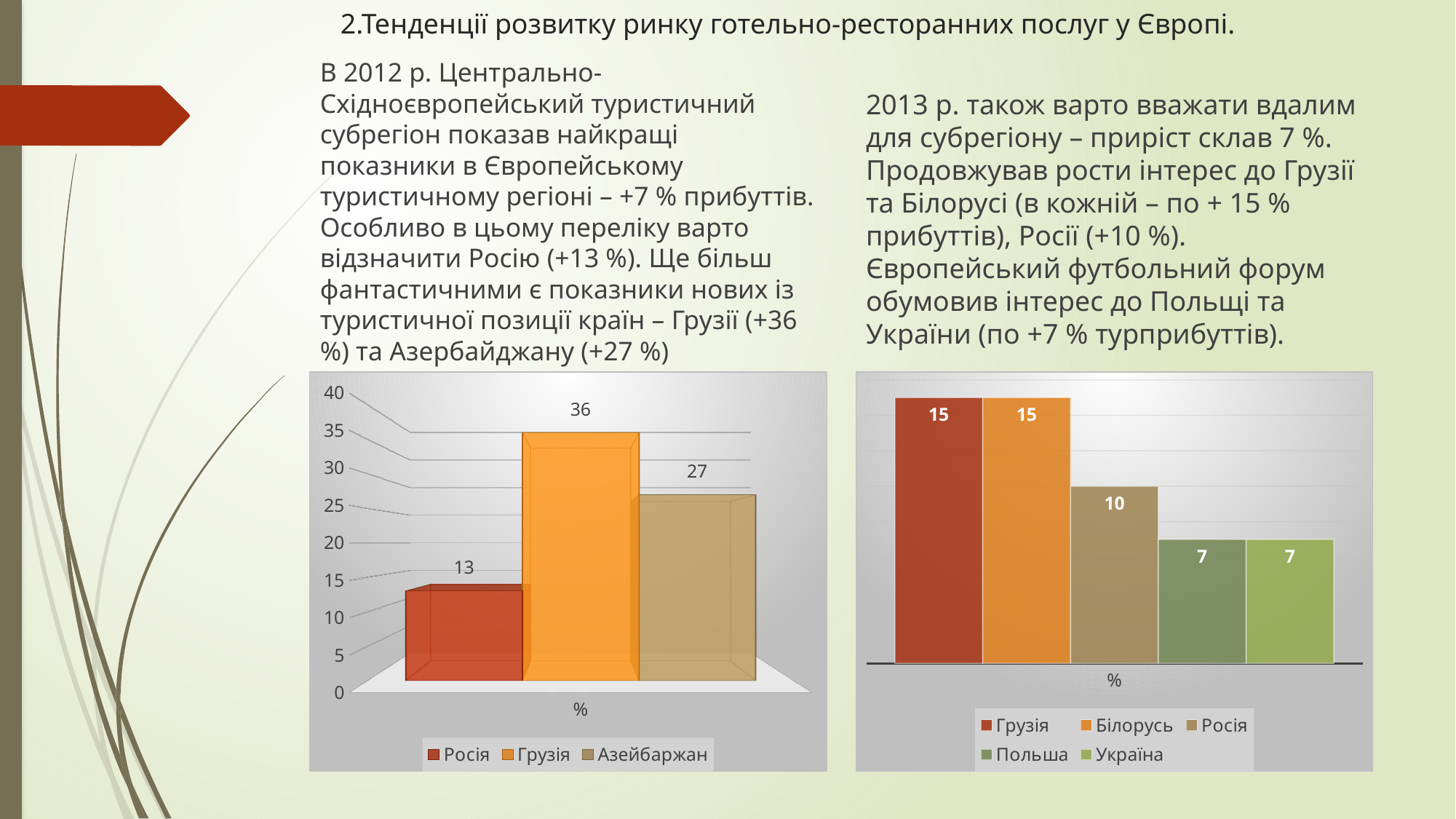
In the left chart, which series has the lowest value? Росія In the right chart, what is the difference between the values for Грузія and Росія? 5 In the right chart, what is the value for Росія? 10 In the left chart, what is the difference between the values for Грузія and Азейбаржан? 9 In the right chart, which is larger, the value for Білорусь or the value for Україна? Білорусь In the left chart, which series has the highest value? Грузія In the left chart, how many series does the legend list? 3 In the right chart, what is the value for Польша? 7 What kind of chart is the left chart? Bar chart In the right chart, how many series does the legend list? 5 In the left chart, what is the value for Росія? 13 In the left chart, what is the value for Грузія? 36